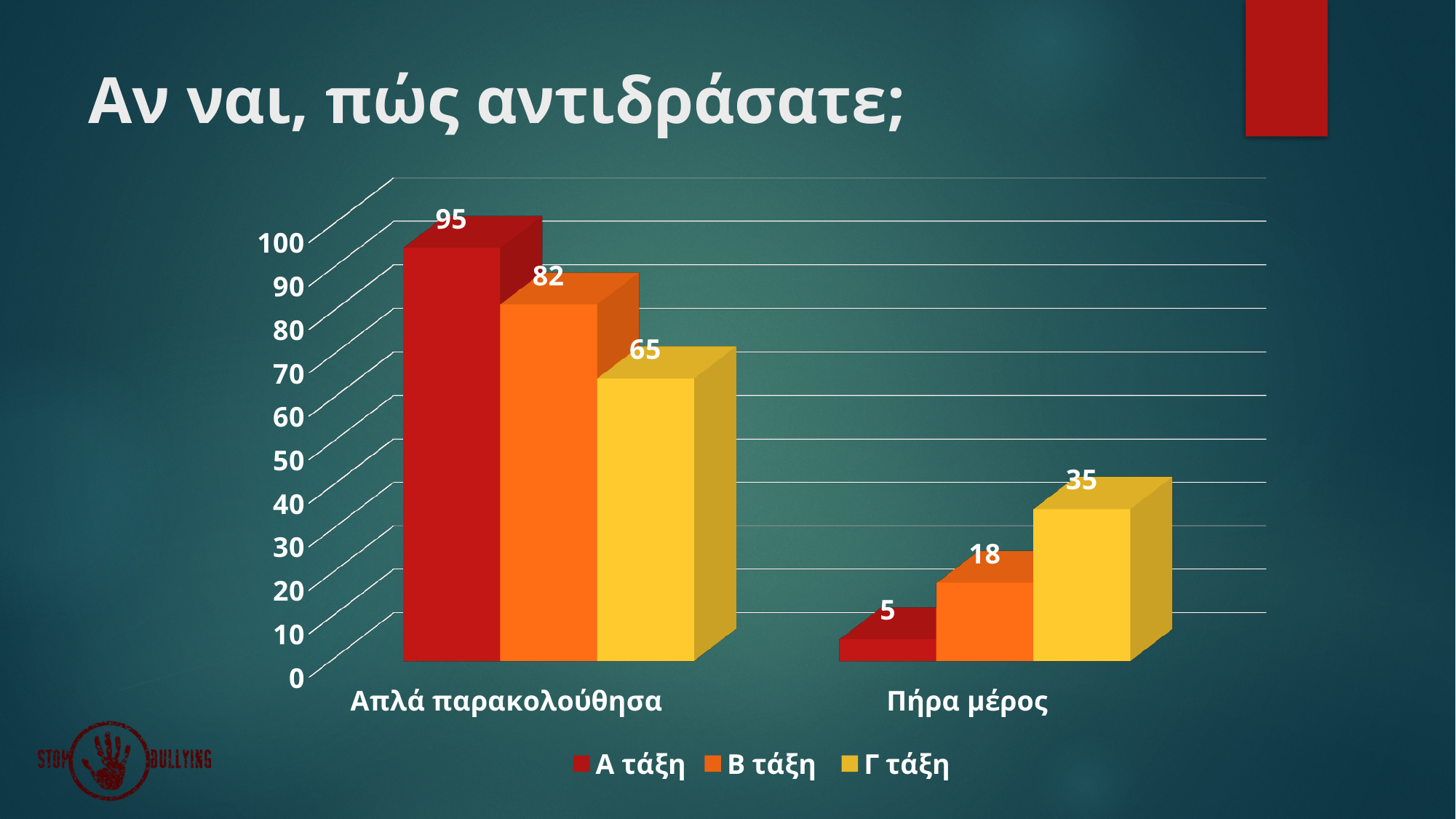
What is the value for Α τάξη in the Απλά παρακολούθησα category? 95 Which is larger: the Β τάξη value for Απλά παρακολούθησα or the Γ τάξη value for Πήρα μέρος? Β τάξη value for Απλά παρακολούθησα Which series has the lowest value in the Πήρα μέρος category? Α τάξη What is the value for Γ τάξη in the Πήρα μέρος category? 35 What is the value for Β τάξη in the Πήρα μέρος category? 18 What is the title of the slide? Αν ναι, πώς αντιδράσατε; What kind of chart is shown on the slide? Bar chart How many series does the legend list? 3 What is the difference between the Α τάξη and Γ τάξη values in the Απλά παρακολούθησα category? 30 Which series has the highest value in the Απλά παρακολούθησα category? Α τάξη What is the difference between the Γ τάξη and Β τάξη values in the Πήρα μέρος category? 17 How many categories are shown on the x axis? 2